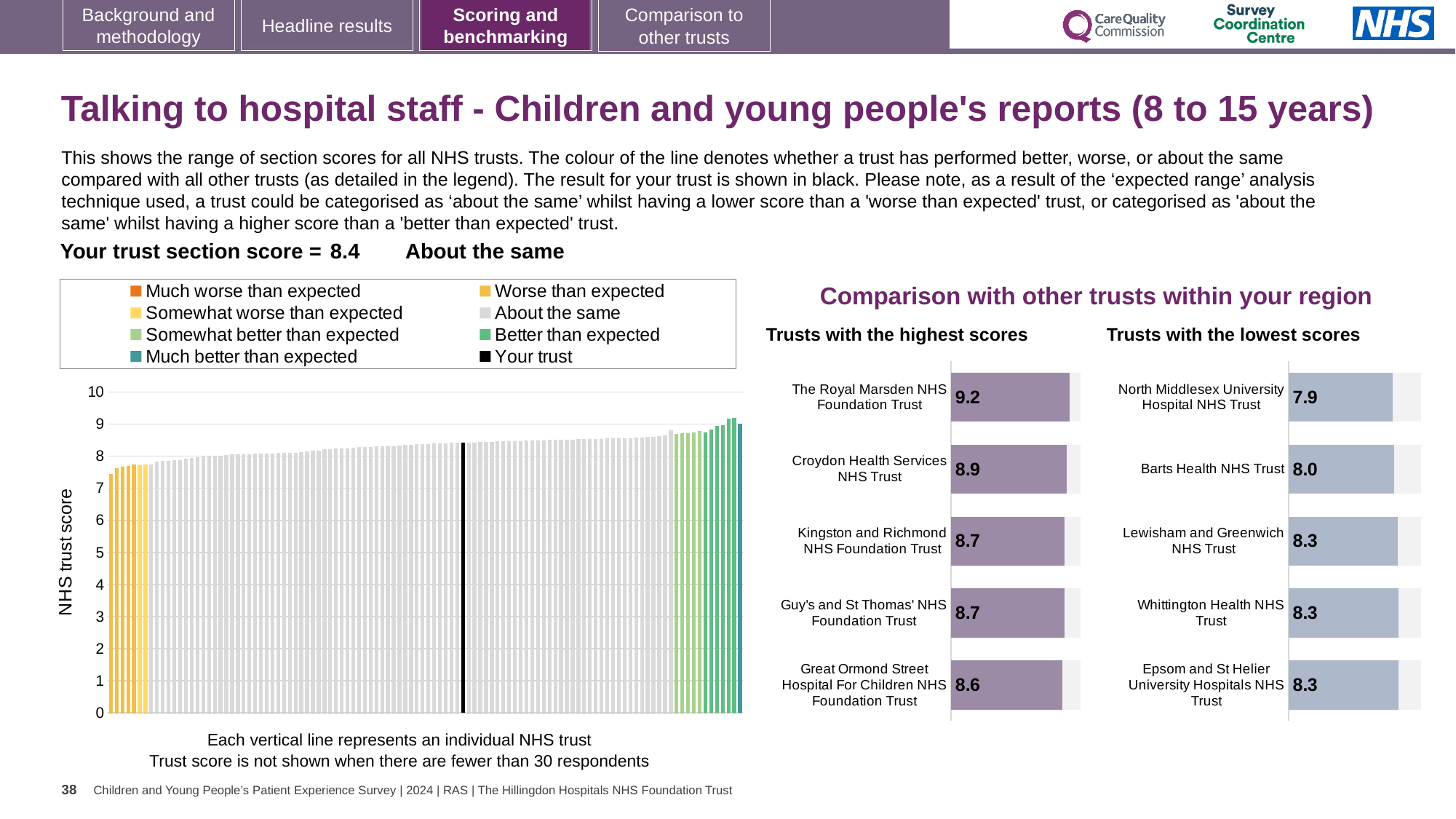
In the 'Trusts with the lowest scores' chart, which trust has the lowest score? North Middlesex University Hospital NHS Trust How many trusts are shown in the 'Trusts with the lowest scores' chart? 5 In the 'Trusts with the lowest scores' chart, which has the larger score: Barts Health NHS Trust or North Middlesex University Hospital NHS Trust? Barts Health NHS Trust In the 'Trusts with the highest scores' chart, what is the score for The Royal Marsden NHS Foundation Trust? 9.2 In the 'Trusts with the highest scores' chart, which trust has the highest score? The Royal Marsden NHS Foundation Trust In the 'Trusts with the lowest scores' chart, what is the difference between the scores of Barts Health NHS Trust and North Middlesex University Hospital NHS Trust? 0.1 In the 'Trusts with the highest scores' chart, what is the score for Great Ormond Street Hospital For Children NHS Foundation Trust? 8.6 In the large chart on the left showing all NHS trusts, what is the section score for your trust (the black bar)? 8.4 What kind of chart is the large chart on the left showing all NHS trusts? Bar chart In the 'Trusts with the lowest scores' chart, what is the score for North Middlesex University Hospital NHS Trust? 7.9 In the 'Trusts with the highest scores' chart, what is the difference between the scores of The Royal Marsden NHS Foundation Trust and Great Ormond Street Hospital For Children NHS Foundation Trust? 0.6 How many entries does the legend above the large chart on the left list? 8